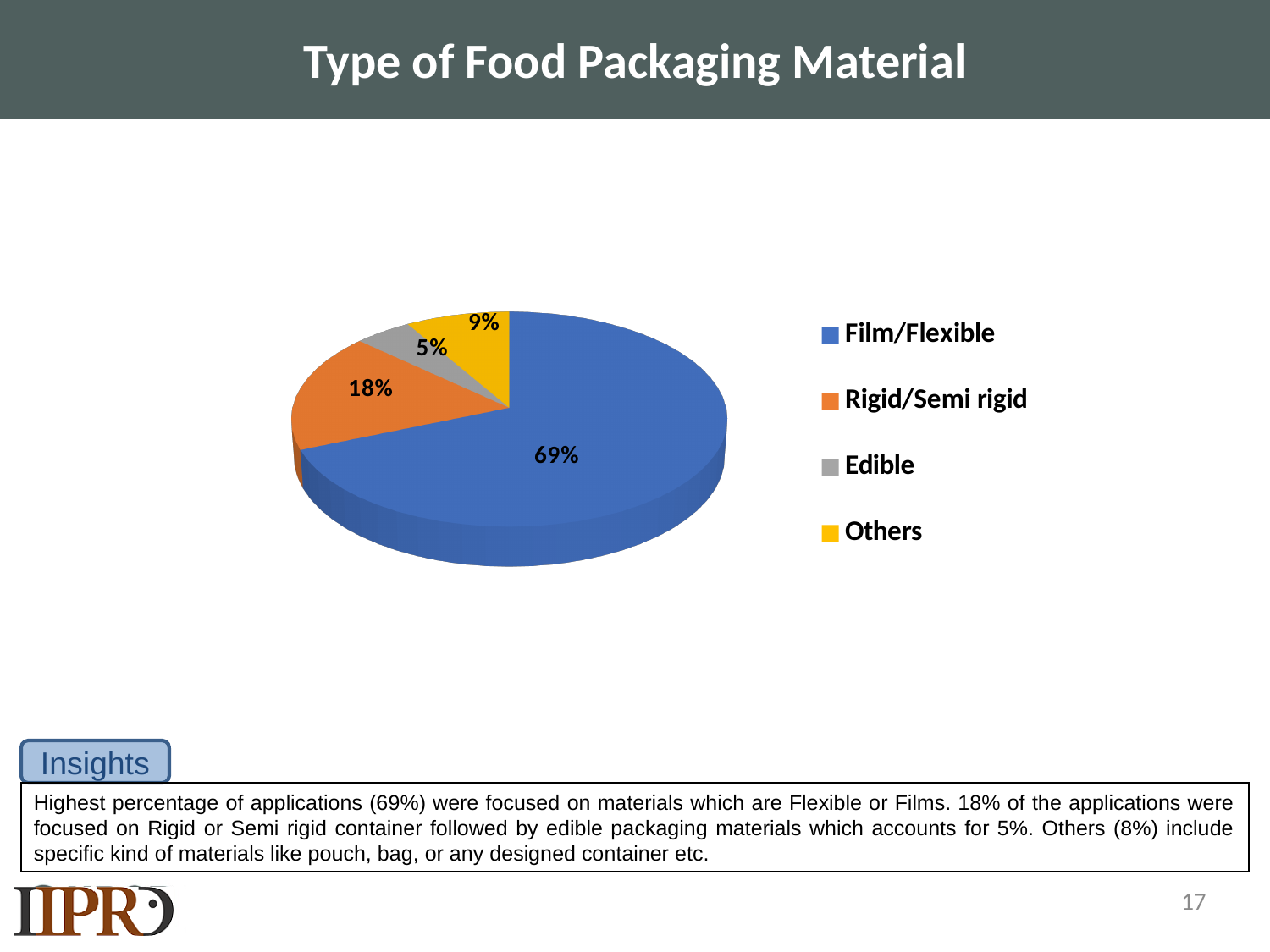
What is the title of the slide containing the chart? Type of Food Packaging Material What colour represents Rigid/Semi rigid in the pie chart? Orange Which is larger, the share for Others or the share for Edible? Others What is the difference in percentage points between Film/Flexible and Rigid/Semi rigid? 51 What percentage of the pie chart is Edible? 5% How many categories does the pie chart show? 4 What percentage of the pie chart is Rigid/Semi rigid? 18% What percentage of the pie chart is Others? 9% What percentage of the pie chart is Film/Flexible? 69% Which category has the largest share of the pie chart? Film/Flexible Which category has the smallest share of the pie chart? Edible What type of chart is shown on the slide? Pie chart